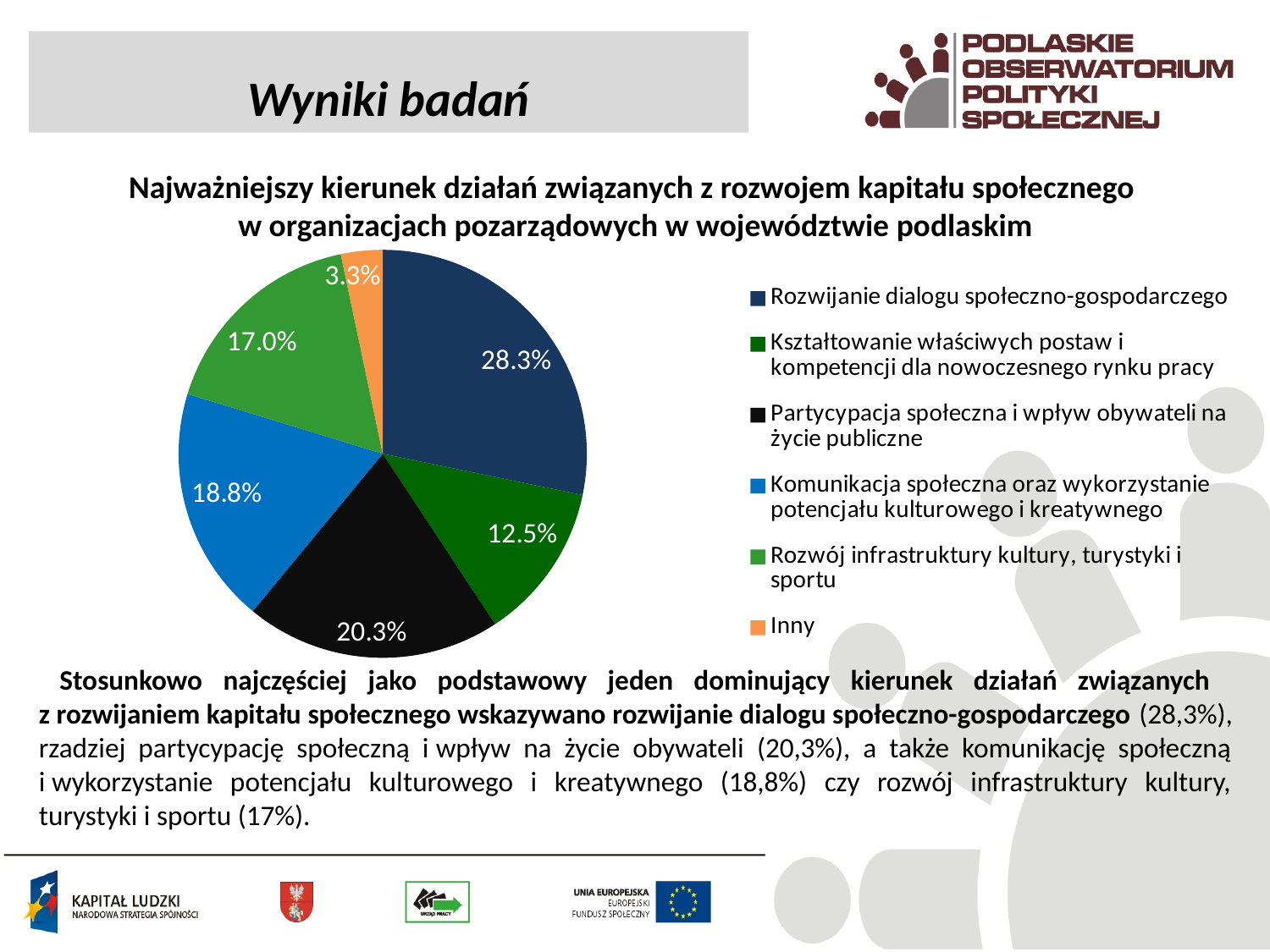
Which category has the largest share of the pie? Rozwijanie dialogu społeczno-gospodarczego Which is larger: the share for "Partycypacja społeczna i wpływ obywateli na życie publiczne" or for "Komunikacja społeczna oraz wykorzystanie potencjału kulturowego i kreatywnego"? Partycypacja społeczna i wpływ obywateli na życie publiczne What is the value for "Partycypacja społeczna i wpływ obywateli na życie publiczne"? 20.3% What is the difference between the shares for "Rozwijanie dialogu społeczno-gospodarczego" and "Kształtowanie właściwych postaw i kompetencji dla nowoczesnego rynku pracy"? 15.8 percentage points What is the value for "Rozwój infrastruktury kultury, turystyki i sportu"? 17.0% What share of the pie does "Rozwijanie dialogu społeczno-gospodarczego" have? 28.3% What is the value for "Inny"? 3.3% Which category has the smallest share of the pie? Inny What kind of chart is shown on the slide? pie chart What is the value for "Komunikacja społeczna oraz wykorzystanie potencjału kulturowego i kreatywnego"? 18.8% How many categories does the legend of the pie chart list? 6 What colour is the slice for "Inny"? orange